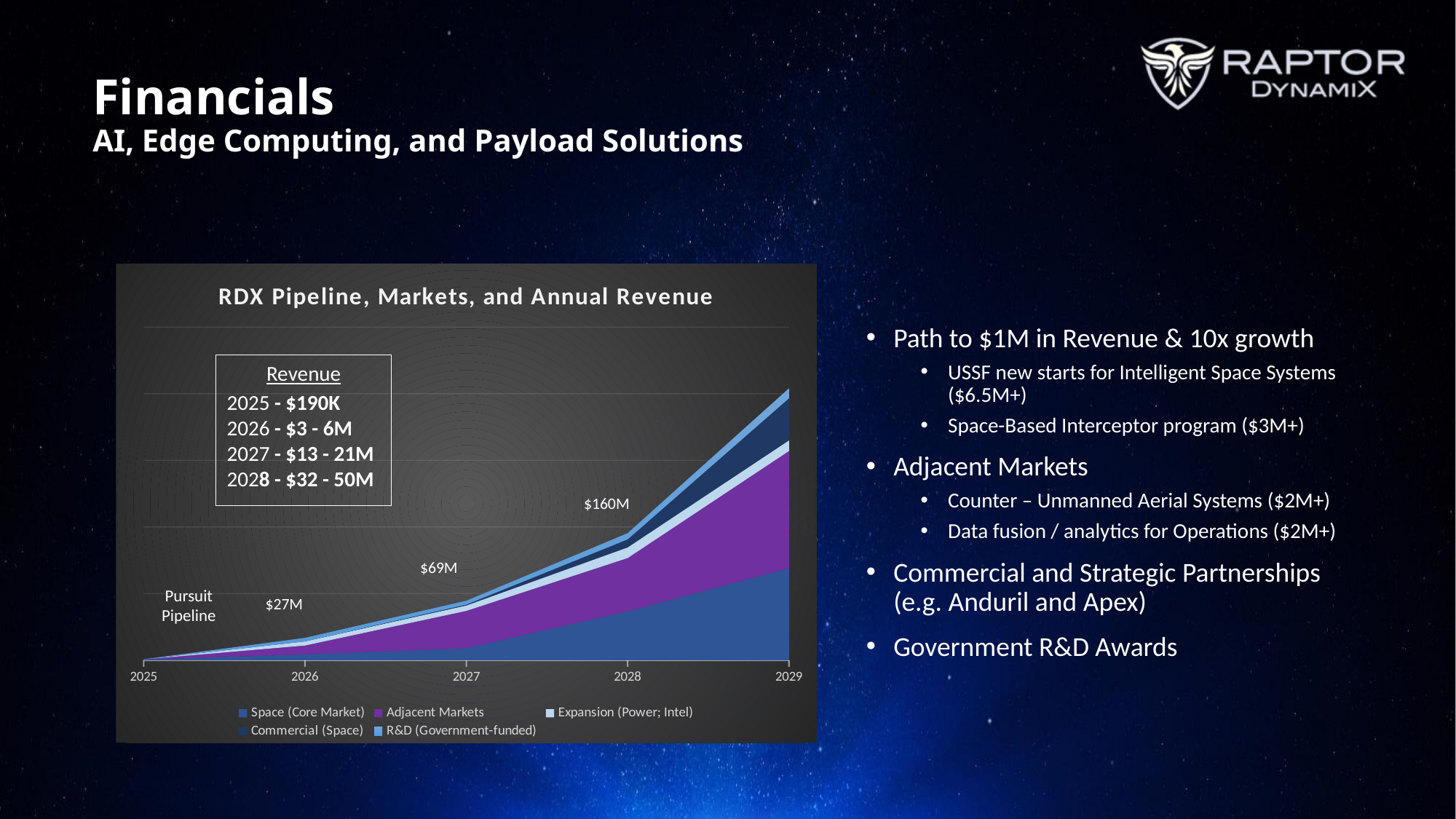
What is the title of the chart? RDX Pipeline, Markets, and Annual Revenue What pipeline value is labelled for 2026 on the chart? $27M What is the difference between the labelled pipeline values for 2028 and 2027? $91M Do the stacked values rise or fall from 2025 to 2029? Rise How many series does the chart's legend list? 5 What revenue is listed for 2025 in the Revenue box on the chart? $190K What pipeline value is labelled for 2028 on the chart? $160M What type of chart is shown on the slide? Stacked area chart What is the difference between the labelled pipeline values for 2027 and 2026? $42M What pipeline value is labelled for 2027 on the chart? $69M How many years are shown along the x axis of the chart? 5 Which year has the larger labelled pipeline value, 2026 or 2028? 2028